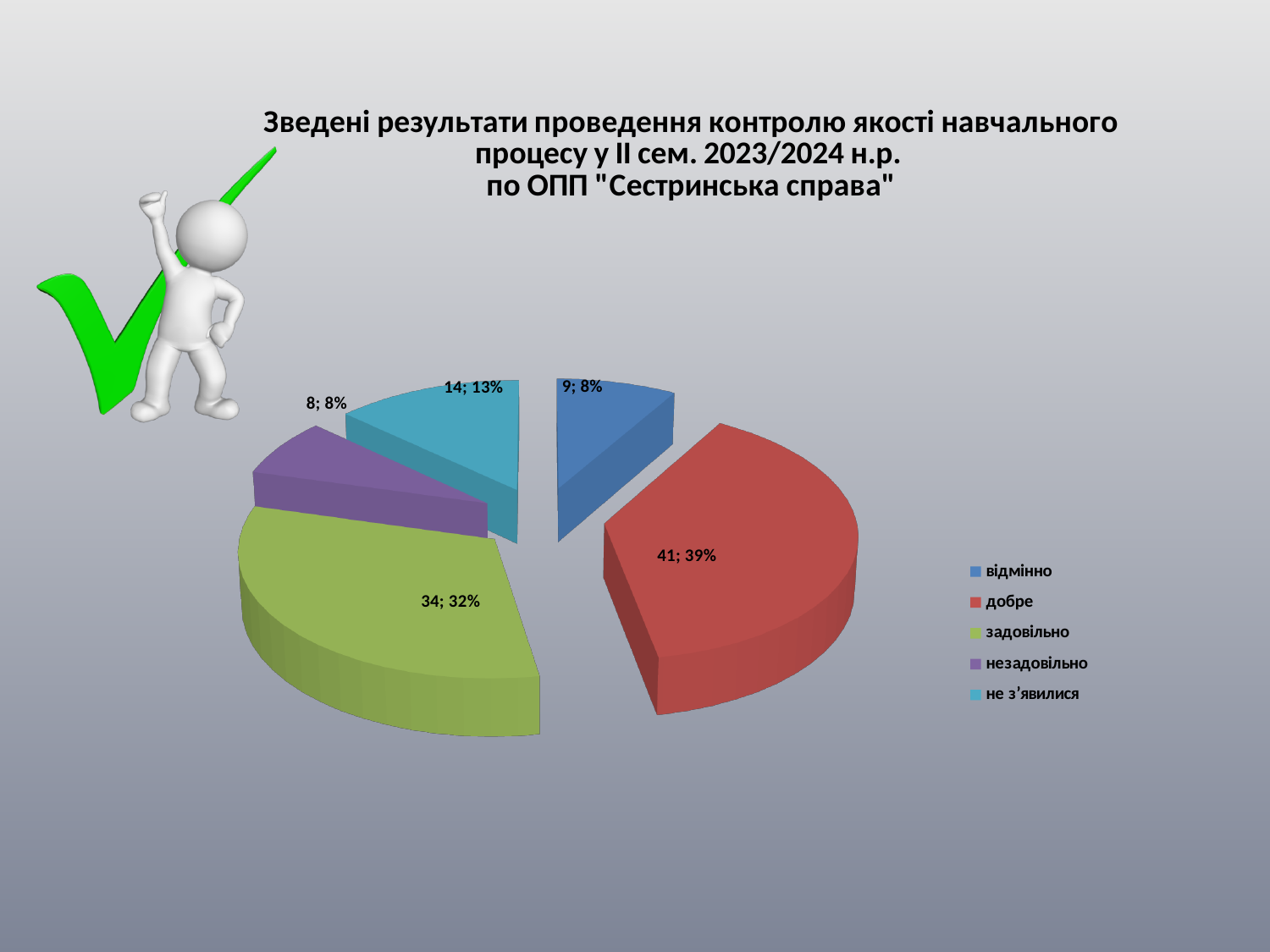
What is the value for "добре"? 41 Which is larger, the value for "не з’явилися" or the value for "відмінно"? не з’явилися How many categories does the pie chart have? 5 What kind of chart is shown on the slide? pie chart What is the difference between the values for "добре" and "задовільно"? 7 What is the total of all values shown in the pie chart? 106 Which colour represents "незадовільно" in the legend? purple What is the value for "не з’явилися"? 14 Which category has the largest slice? добре What share of the pie does "відмінно" represent? 8% Which category has the smallest value? незадовільно What share of the pie does "задовільно" represent? 32%